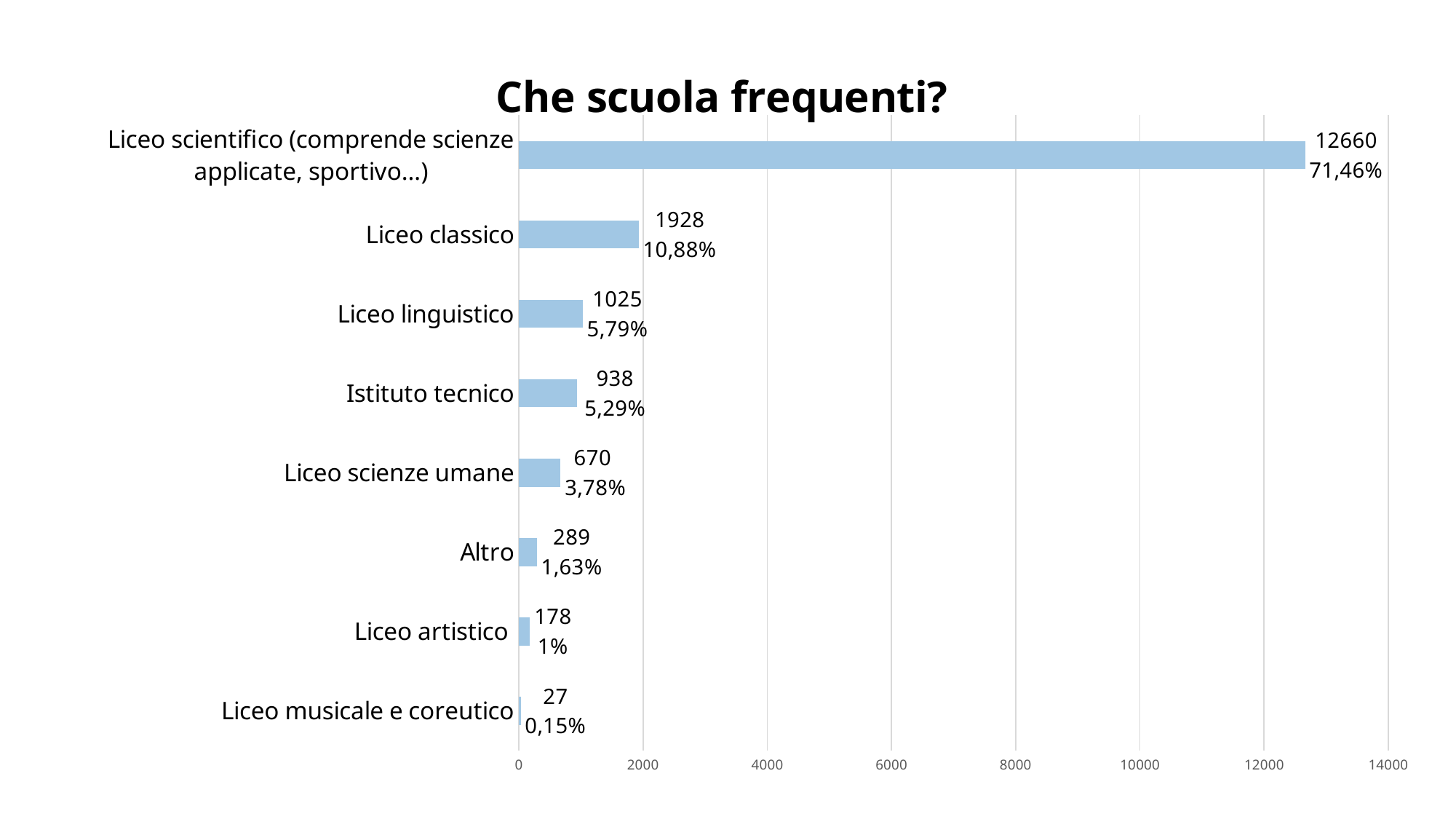
What is the difference between the values for Liceo classico and Liceo linguistico? 903 Which category has the lowest value? Liceo musicale e coreutico What is the title of the chart? Che scuola frequenti? How many categories are shown in the chart? 8 What is the value for Istituto tecnico? 938 What percentage is shown for Liceo musicale e coreutico? 0,15% Which is larger, the value for Altro or the value for Liceo artistico? Altro What percentage is shown for Liceo linguistico? 5,79% Which category has the highest value? Liceo scientifico (comprende scienze applicate, sportivo...) Is the value for Liceo scientifico greater or less than 12000? greater What kind of chart is this? Bar chart What is the value for Liceo classico? 1928